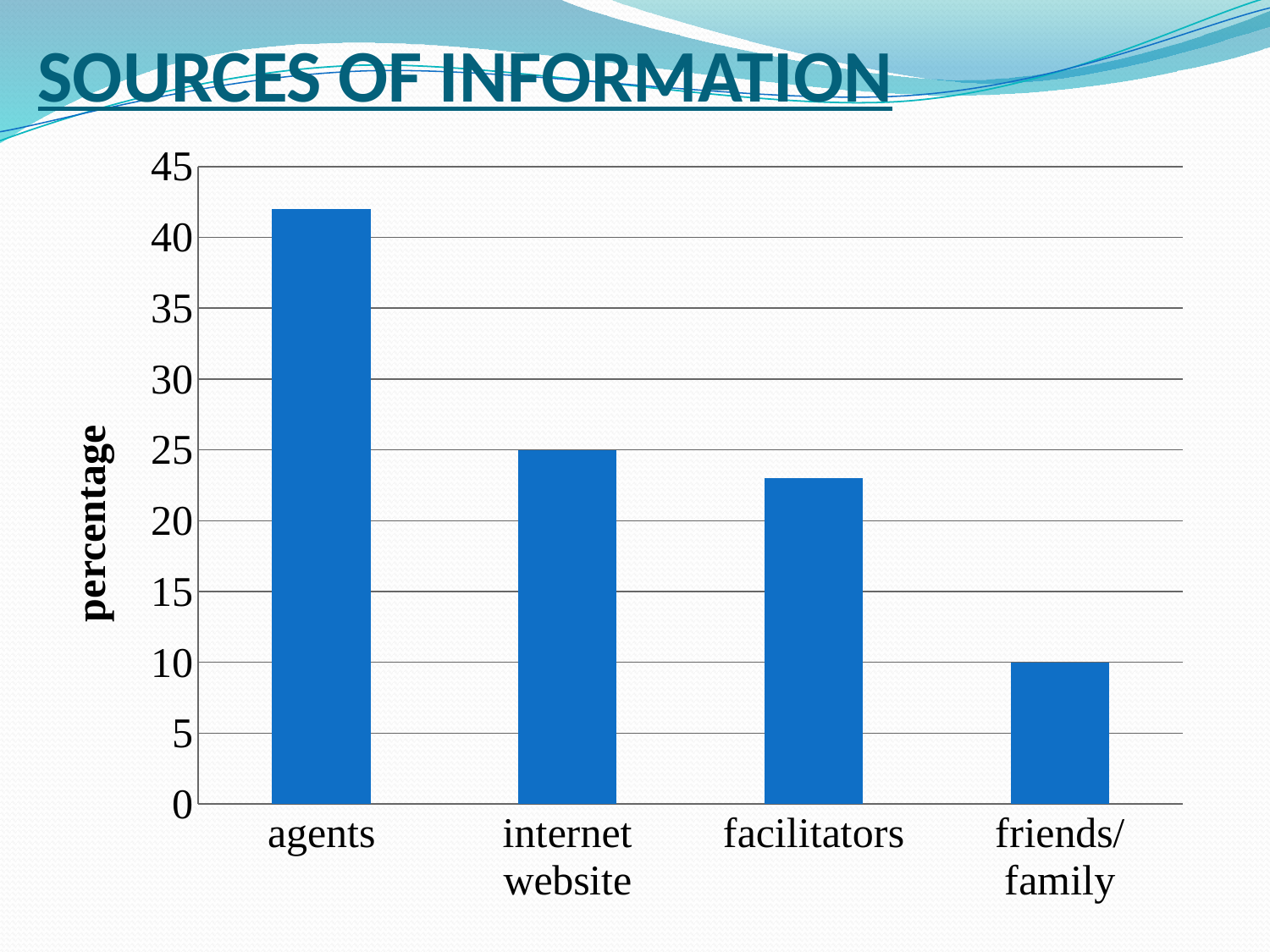
What type of chart is shown on the slide? bar chart What is the title of the chart? SOURCES OF INFORMATION What is the label on the vertical axis? percentage What is the percentage for internet website? 25 What is the percentage for friends/family? 10 Which source of information has the lowest percentage? friends/family Is the value for agents greater or less than 40? greater How many categories are shown on the x axis? 4 What is the difference between the percentage for internet website and the percentage for friends/family? 15 Which source of information has the highest percentage? agents Which is larger, the value for agents or the value for facilitators? agents Is the value for facilitators greater or less than 25? less